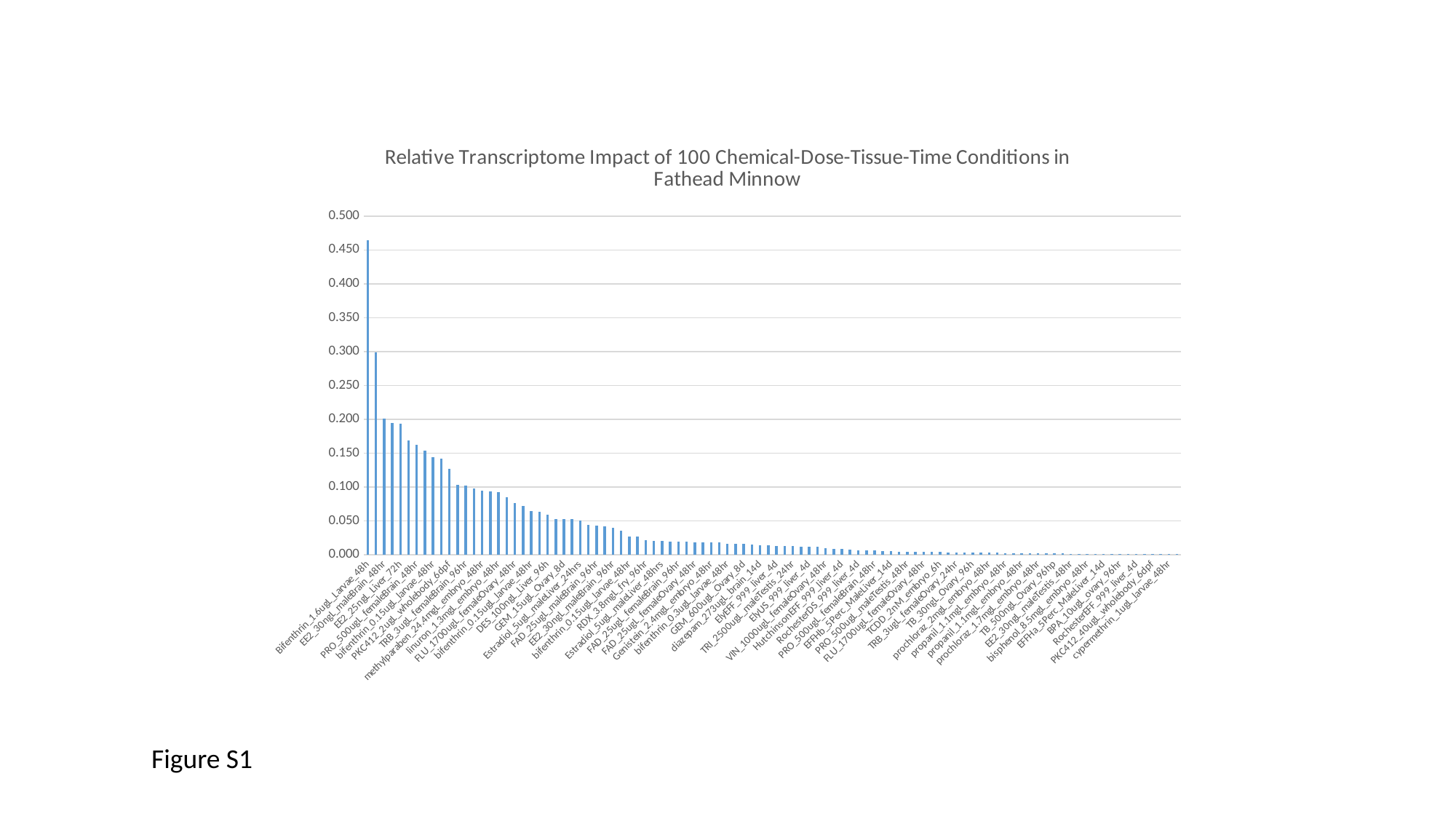
Is the value for EE2_30ngL_maleBrain_48hr greater or less than 0.250? less Is the value for cypermethrin_1ugL_larvae_48hr greater or less than 0.050? less How many chemical-dose-tissue-time conditions are plotted in the chart? 100 Which condition has the highest relative transcriptome impact? Bifenthrin_1.6ugL_Larvae_48h Do the values rise or fall moving left to right along the x axis? Fall Is the value for Bifenthrin_1.6ugL_larvae_48h greater or less than 0.400? greater Which has the larger value, EE2_25ngL_Liver_72h or cypermethrin_1ugL_larvae_48hr? EE2_25ngL_Liver_72h Which has the larger value, Bifenthrin_1.6ugL_larvae_48h or EE2_30ngL_maleBrain_48hr? Bifenthrin_1.6ugL_larvae_48h What is the maximum value shown on the vertical axis? 0.500 What kind of chart is shown on the slide? Bar chart What is the title of the chart? Relative Transcriptome Impact of 100 Chemical-Dose-Tissue-Time Conditions in Fathead Minnow